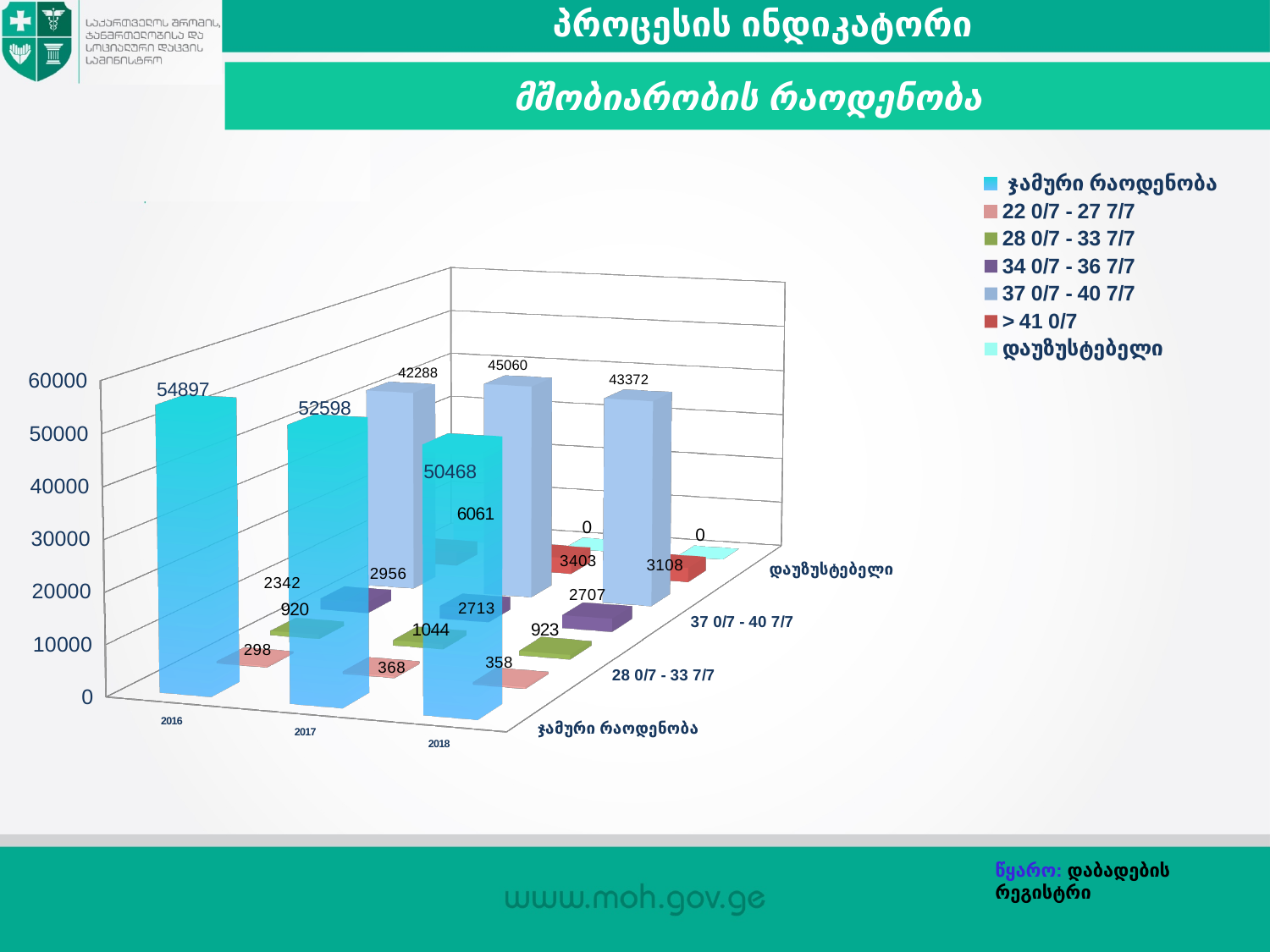
How many years are shown on the x axis? 3 Which year has the highest ჯამური რაოდენობა (total)? 2016 What is the value of ჯამური რაოდენობა (total) for 2016? 54897 What kind of chart is shown on the slide? bar chart What is the difference between the ჯამური რაოდენობა (total) for 2016 and 2017? 2299 Does the ჯამური რაოდენობა (total) rise or fall from 2016 to 2018? fall Which year has the lowest value for the 37 0/7 - 40 7/7 series? 2016 What is the value of ჯამური რაოდენობა (total) for 2018? 50468 What is the value for the 22 0/7 - 27 7/7 series in 2016? 298 What is the value for the 37 0/7 - 40 7/7 series in 2017? 45060 Which is larger: the 37 0/7 - 40 7/7 value for 2017 or for 2018? 2017 How many series does the legend list? 7